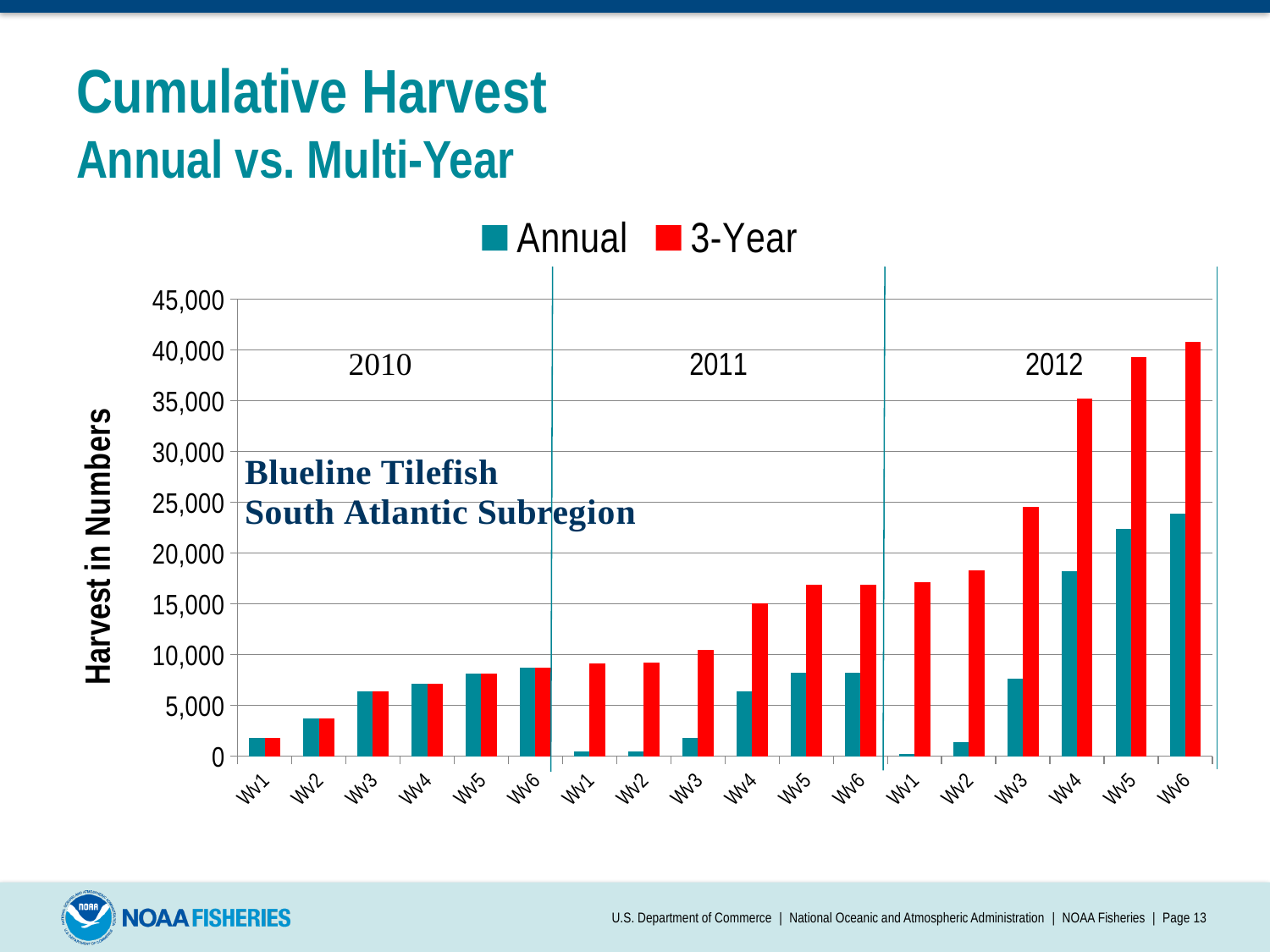
For 2011 Wv6, which is larger, the Annual value or the 3-Year value? 3-Year Which year and wave has the highest Annual value? 2012 Wv6 Do the 3-Year values rise or fall from Wv1 to Wv6 within 2012? Rise How many bar categories (wave labels) are shown along the x axis in total? 18 What is the title of the y axis? Harvest in Numbers Is the Annual value for 2012 Wv5 greater or less than 20,000? greater Which year and wave has the highest 3-Year value? 2012 Wv6 Which year and wave has the lowest 3-Year value? 2010 Wv1 Is the 3-Year value for 2011 Wv4 greater or less than 20,000? less Is the 3-Year value for 2012 Wv5 greater or less than 35,000? greater What type of chart is shown on the slide? Bar chart How many series does the legend list? 2